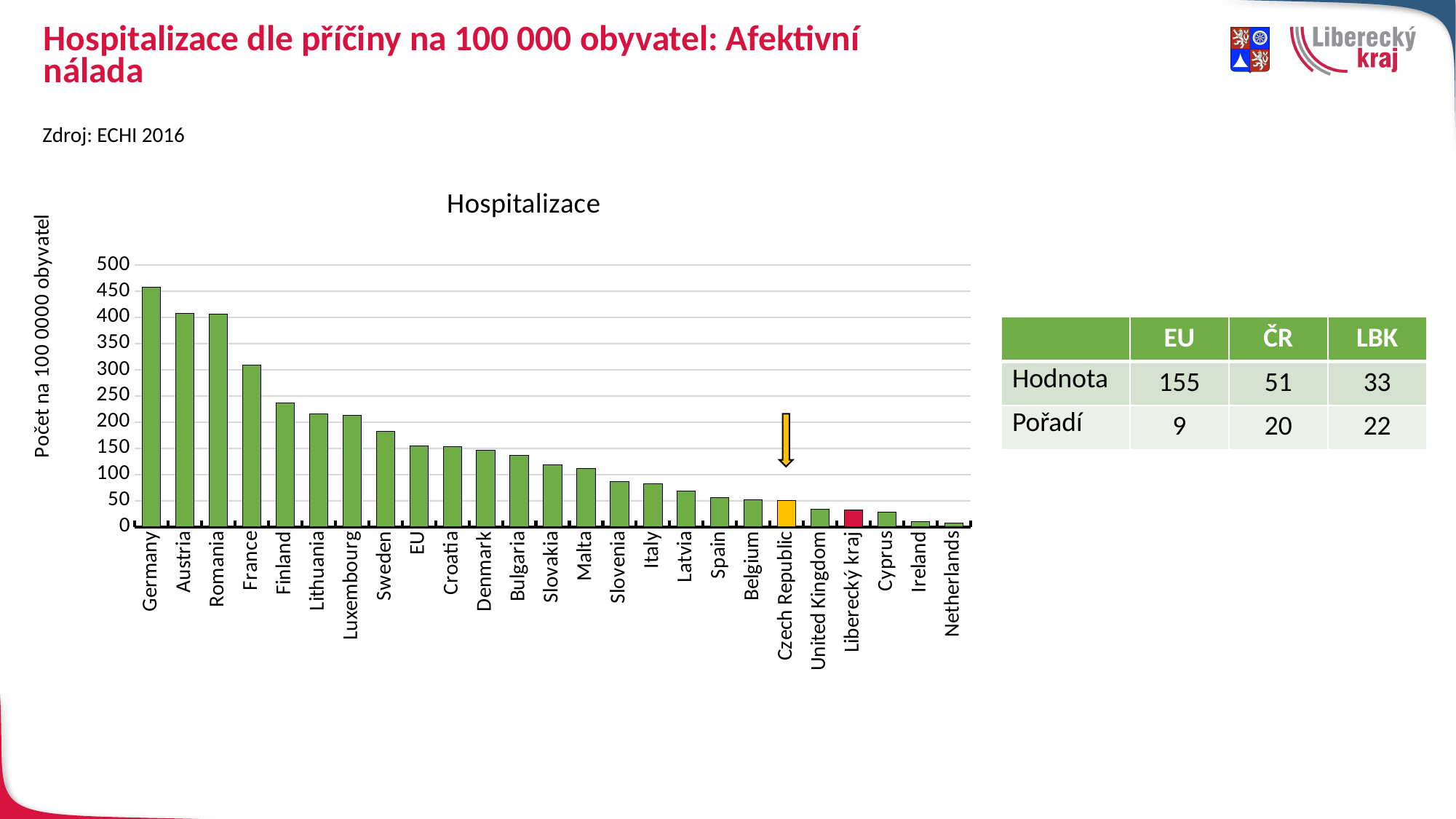
Which category has the highest value in the Hospitalizace chart? Germany What is the value for Liberecký kraj in the Hospitalizace chart? 33 Do the values rise or fall from left to right along the x axis? fall Is the value for Finland greater or less than 200? greater What is the value for EU in the Hospitalizace chart? 155 Which has a larger value, Austria or France? Austria Is the value for Cyprus greater or less than 50? less What is the value for Czech Republic in the Hospitalizace chart? 51 How many categories are plotted in the Hospitalizace chart? 25 What is the difference between the EU value and the Czech Republic value? 104 Is the value for Germany greater or less than 400? greater What type of chart is shown on the slide? bar chart